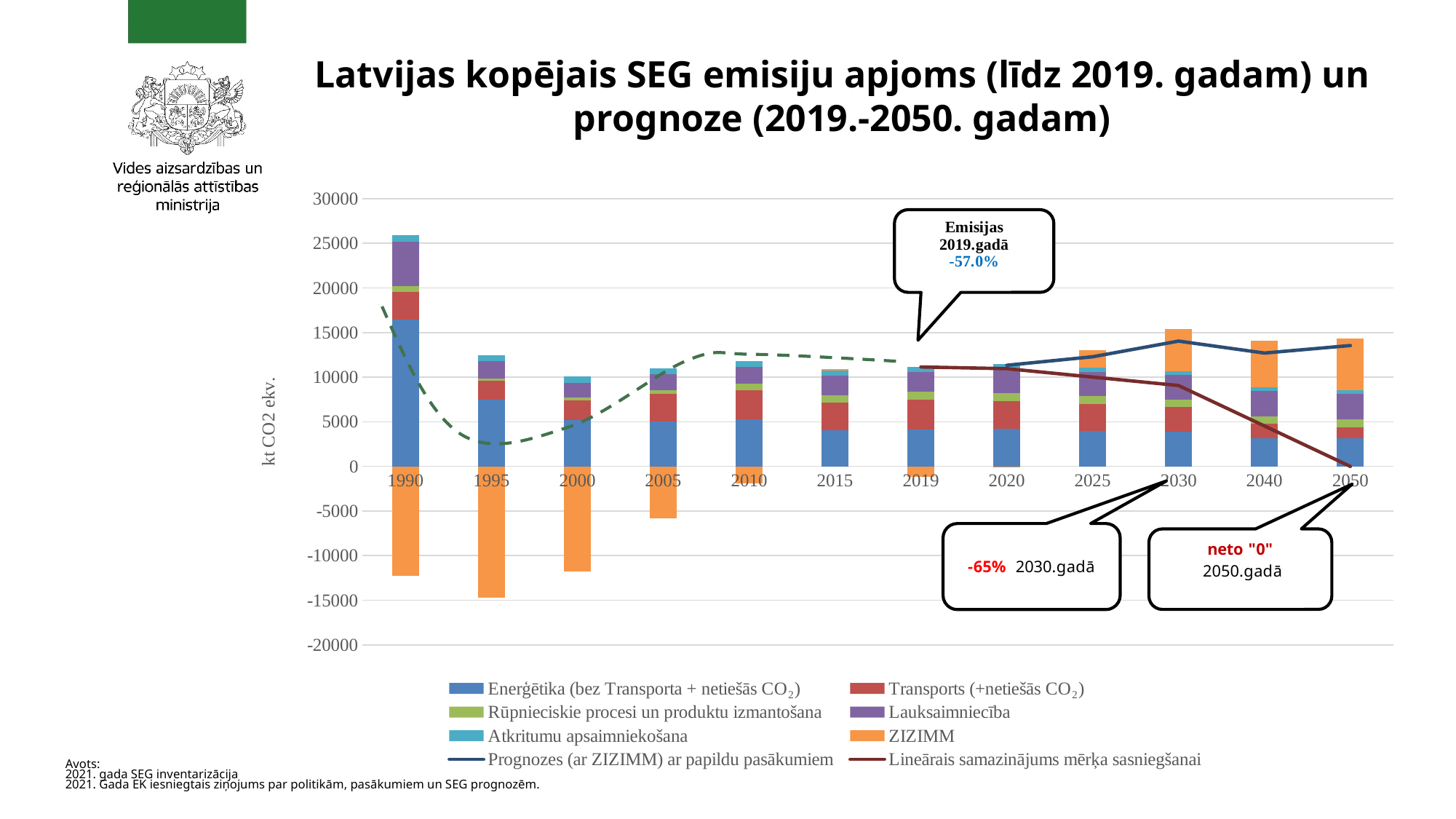
How many entries does the chart legend list? 8 Which year has the tallest positive stacked bar? 1990 According to the callout, by what percentage had emissions changed in 2019? -57.0% Does the Lineārais samazinājums mērķa sasniegšanai line rise or fall from 2019 to 2050? fall In which year does the ZIZIMM series reach its most negative value? 1995 According to the callout, what is the emissions reduction target for 2030? -65% Is the value for Enerģētika (bez Transporta + netiešās CO2) in 1990 greater or less than 15000? greater How many years are shown along the x axis of the chart? 12 Is the value for ZIZIMM in 2005 greater or less than -10000? greater Is the value for ZIZIMM in 1995 greater or less than -10000? less What is the label on the vertical axis of the chart? kt CO2 ekv. What kind of chart is shown on the slide? combination bar and line chart (stacked bars with lines)